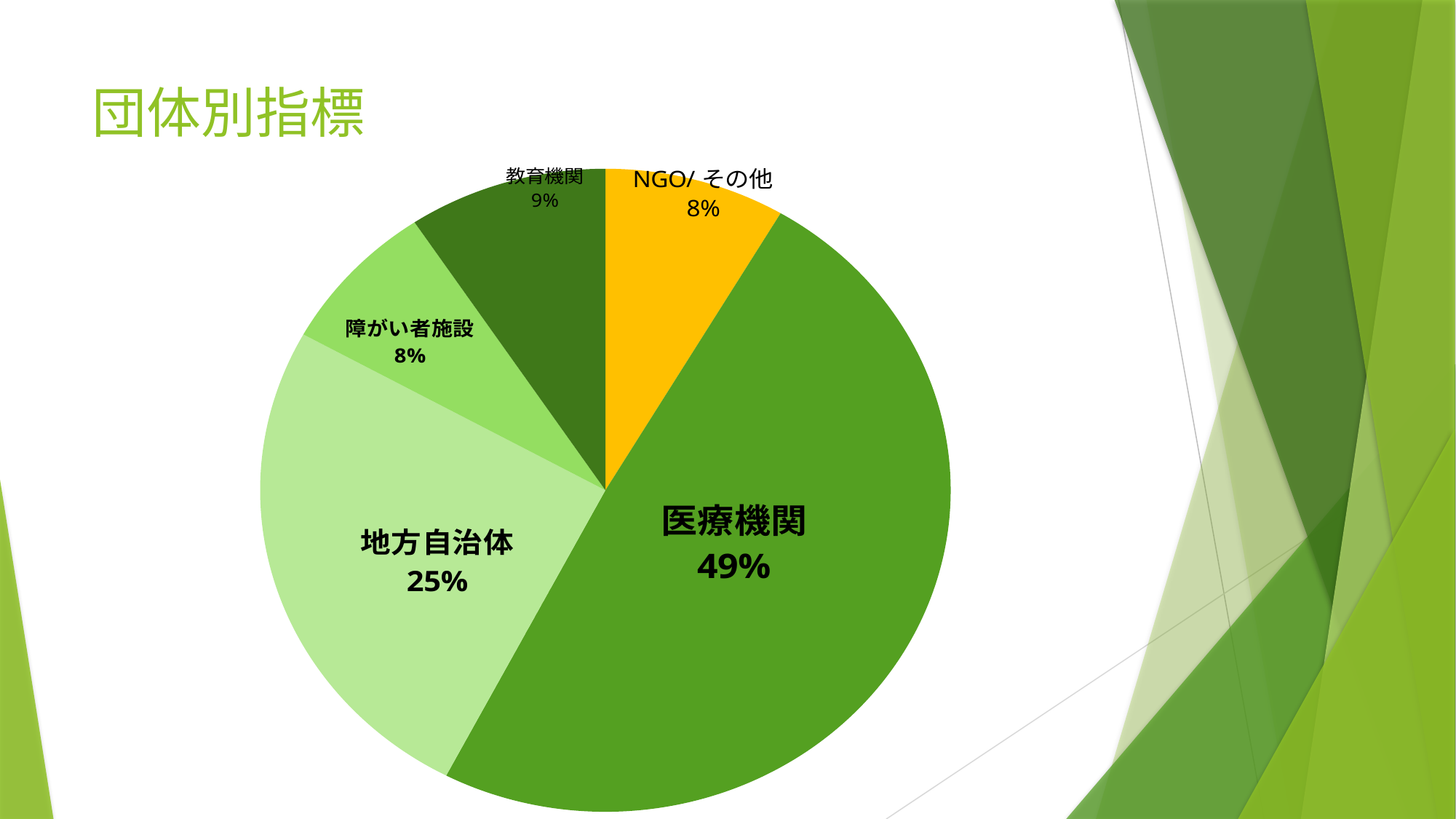
What kind of chart is shown on the slide? pie chart What is the title of the slide containing the chart? 団体別指標 What is the difference in percentage points between 医療機関 and 地方自治体? 24 Which slice of the pie is coloured orange/yellow? NGO/ その他 What percentage is shown for 教育機関? 9% Which category has the largest slice of the pie? 医療機関 Which is larger, the share for 教育機関 or the share for NGO/ その他? 教育機関 What percentage is shown for NGO/ その他? 8% What percentage is shown for 障がい者施設? 8% How many slices does the pie chart have? 5 What share of the pie does 医療機関 represent? 49% What percentage is shown for 地方自治体? 25%